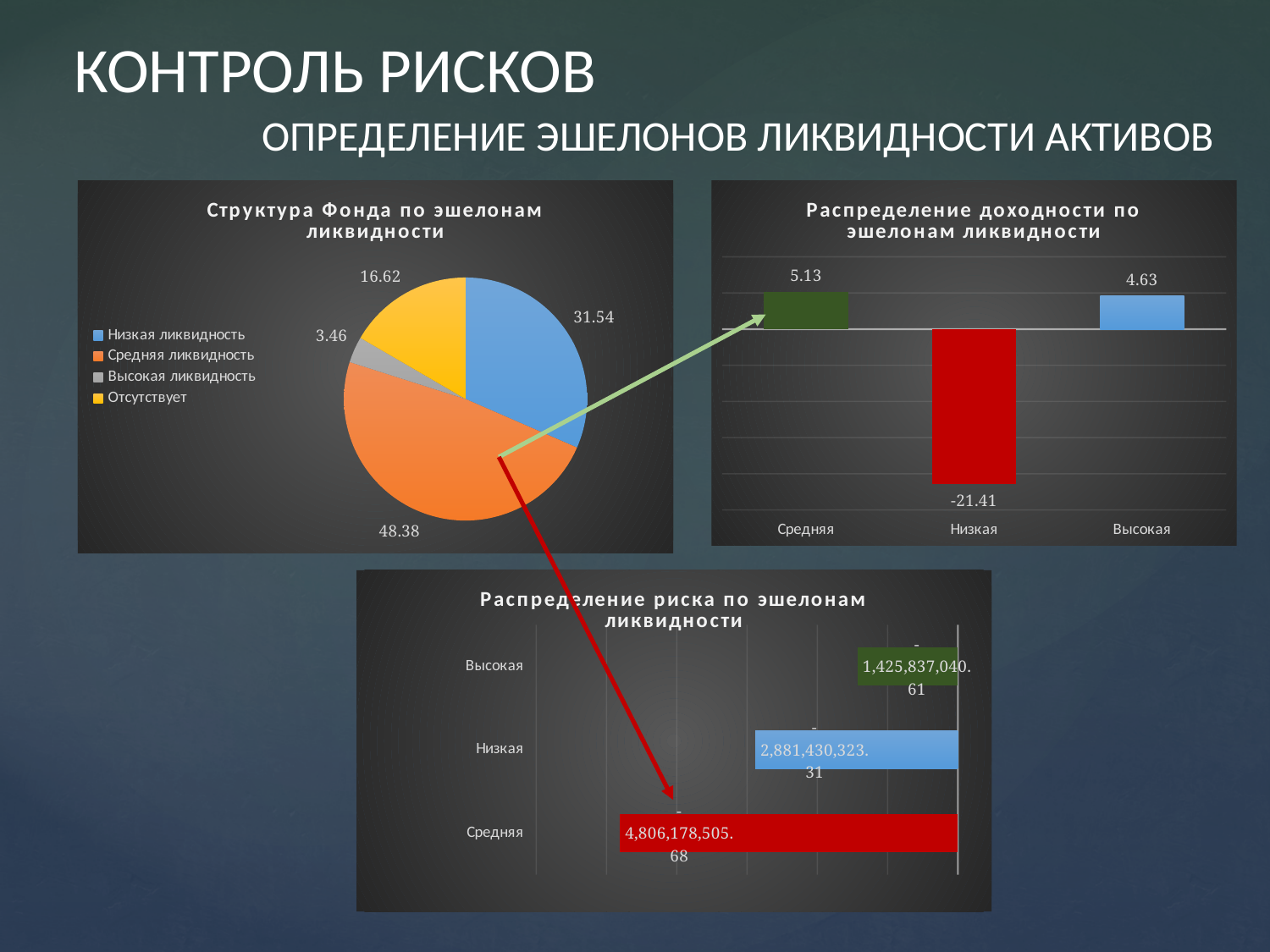
In the pie chart 'Структура Фонда по эшелонам ликвидности', which category has the largest slice? Средняя ликвидность In the pie chart 'Структура Фонда по эшелонам ликвидности', what is the value for Средняя ликвидность? 48.38 In the chart 'Распределение риска по эшелонам ликвидности', which category has the longest bar? Средняя In the chart 'Распределение доходности по эшелонам ликвидности', what is the value for Низкая? -21.41 In the pie chart 'Структура Фонда по эшелонам ликвидности', how many categories does the legend list? 4 In the pie chart 'Структура Фонда по эшелонам ликвидности', which category has the smallest slice? Высокая ликвидность In the pie chart 'Структура Фонда по эшелонам ликвидности', what is the value for Высокая ликвидность? 3.46 In the pie chart 'Структура Фонда по эшелонам ликвидности', what is the difference between the values for Низкая ликвидность and Отсутствует? 14.92 In the chart 'Распределение доходности по эшелонам ликвидности', what is the difference between the values for Средняя and Высокая? 0.5 In the chart 'Распределение доходности по эшелонам ликвидности', what is the value for Средняя? 5.13 In the chart 'Распределение доходности по эшелонам ликвидности', which category has the highest value? Средняя What kind of chart is 'Распределение риска по эшелонам ликвидности'? bar chart